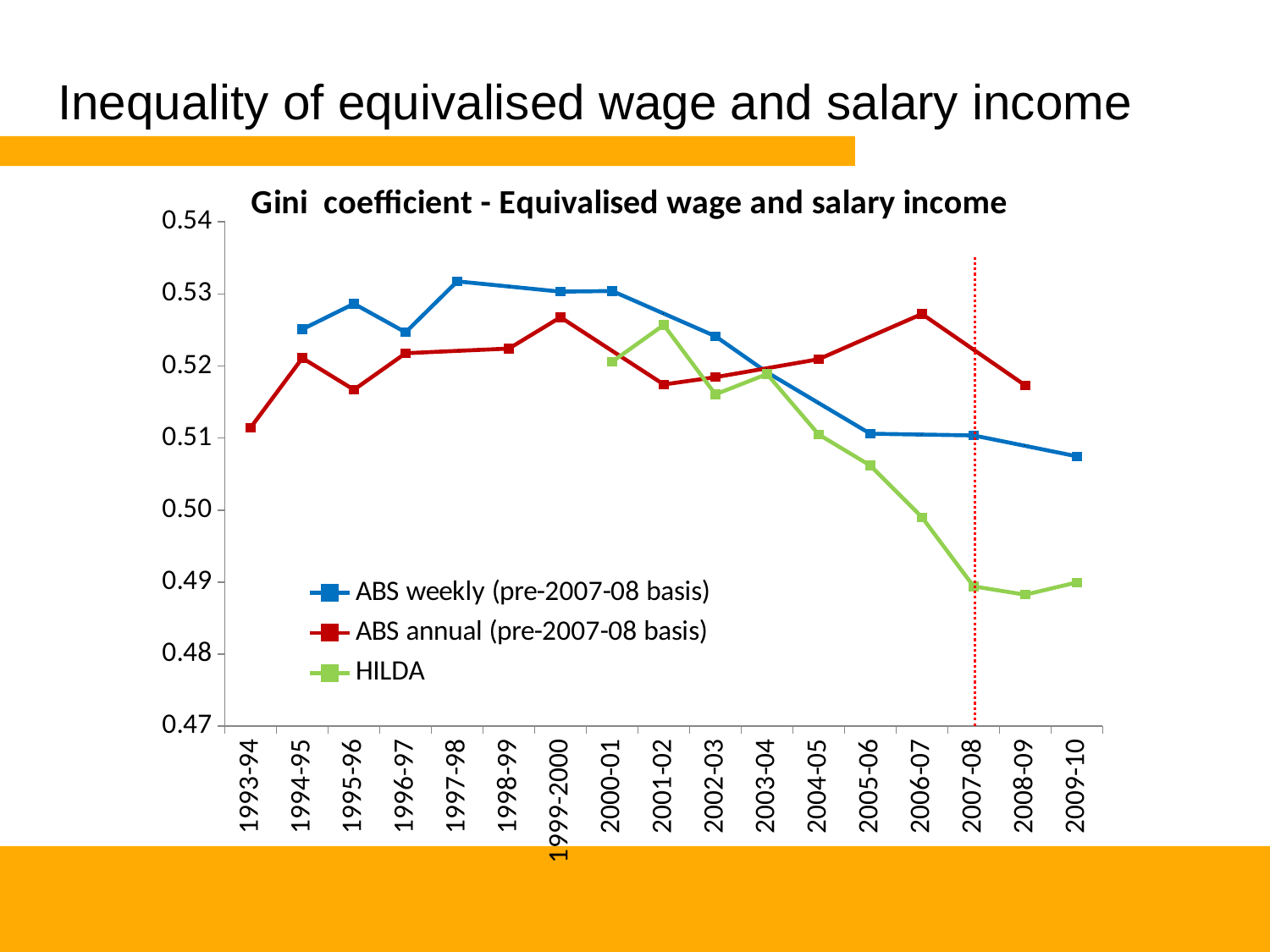
What is the title of the chart? Gini coefficient - Equivalised wage and salary income How many series does the legend list? 3 Is the HILDA value for 2005-06 greater or less than 0.50? greater In which year is the ABS annual (pre-2007-08 basis) series at its lowest value? 1993-94 Does the HILDA series rise or fall from 2001-02 to 2007-08? fall In 2007-08, which series has the higher value: ABS annual (pre-2007-08 basis) or ABS weekly (pre-2007-08 basis)? ABS annual (pre-2007-08 basis) What kind of chart is shown on the slide? line chart Is the ABS annual (pre-2007-08 basis) value for 2006-07 greater or less than 0.52? greater How many financial years are shown along the x axis? 17 What colour is the HILDA line? green Is the ABS weekly (pre-2007-08 basis) value for 2009-10 greater or less than 0.51? less In which year does the HILDA series reach its highest value? 2001-02